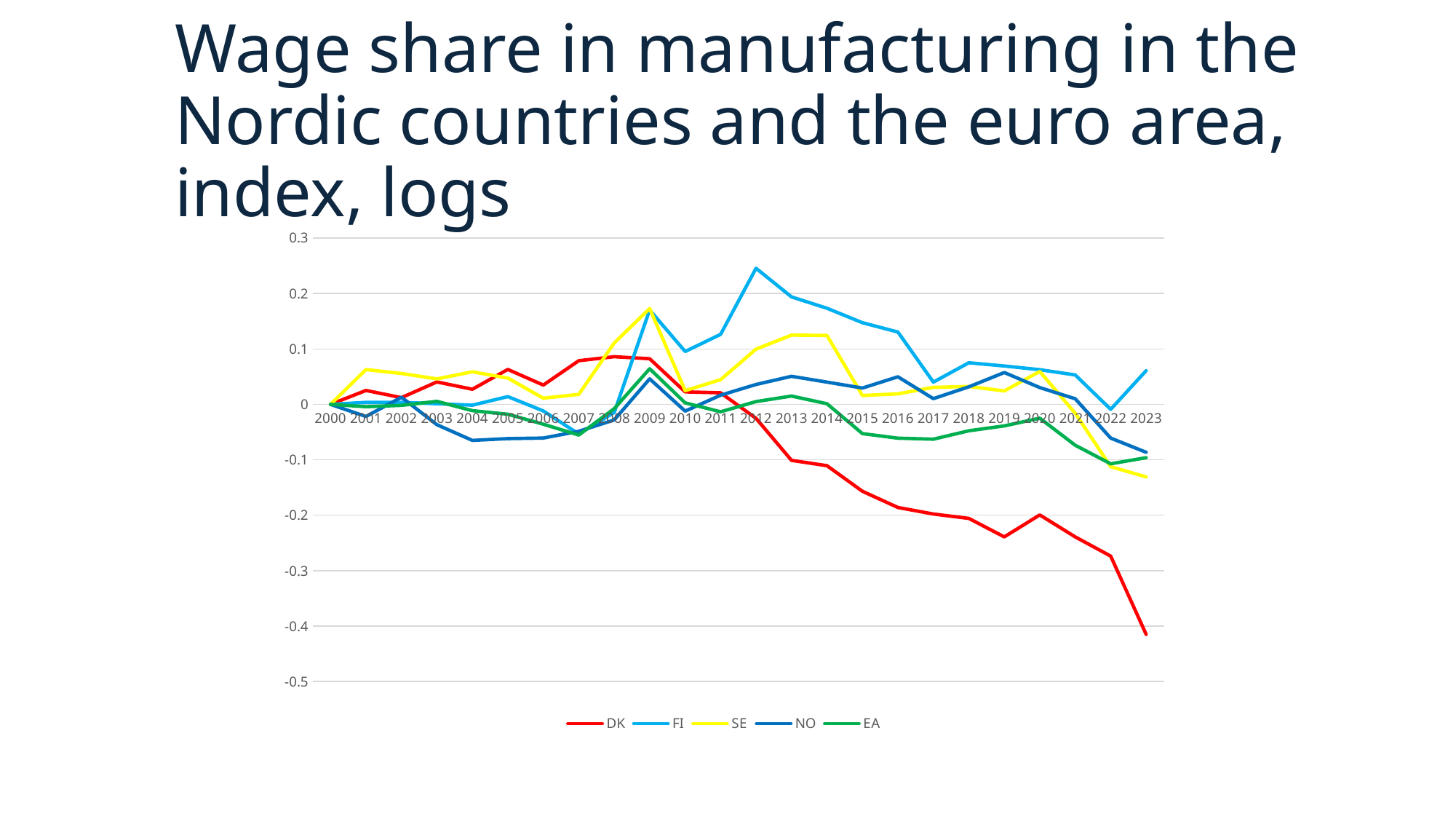
What kind of chart is shown on the slide? line chart Does the DK series rise or fall overall from 2012 to 2023? fall Is the value for DK in 2019 greater or less than -0.2? less In 2023, which is larger, the value for FI or the value for DK? FI Which series reaches the highest point anywhere on the chart? FI Which series has the lowest value in 2023? DK Which colour is used for the DK series? red How many series does the legend list? 5 How many years are shown along the x axis? 24 Is the value for DK in 2023 greater or less than -0.4? less Is the value for FI in 2012 greater or less than 0.2? greater Which series has the highest value in 2023? FI